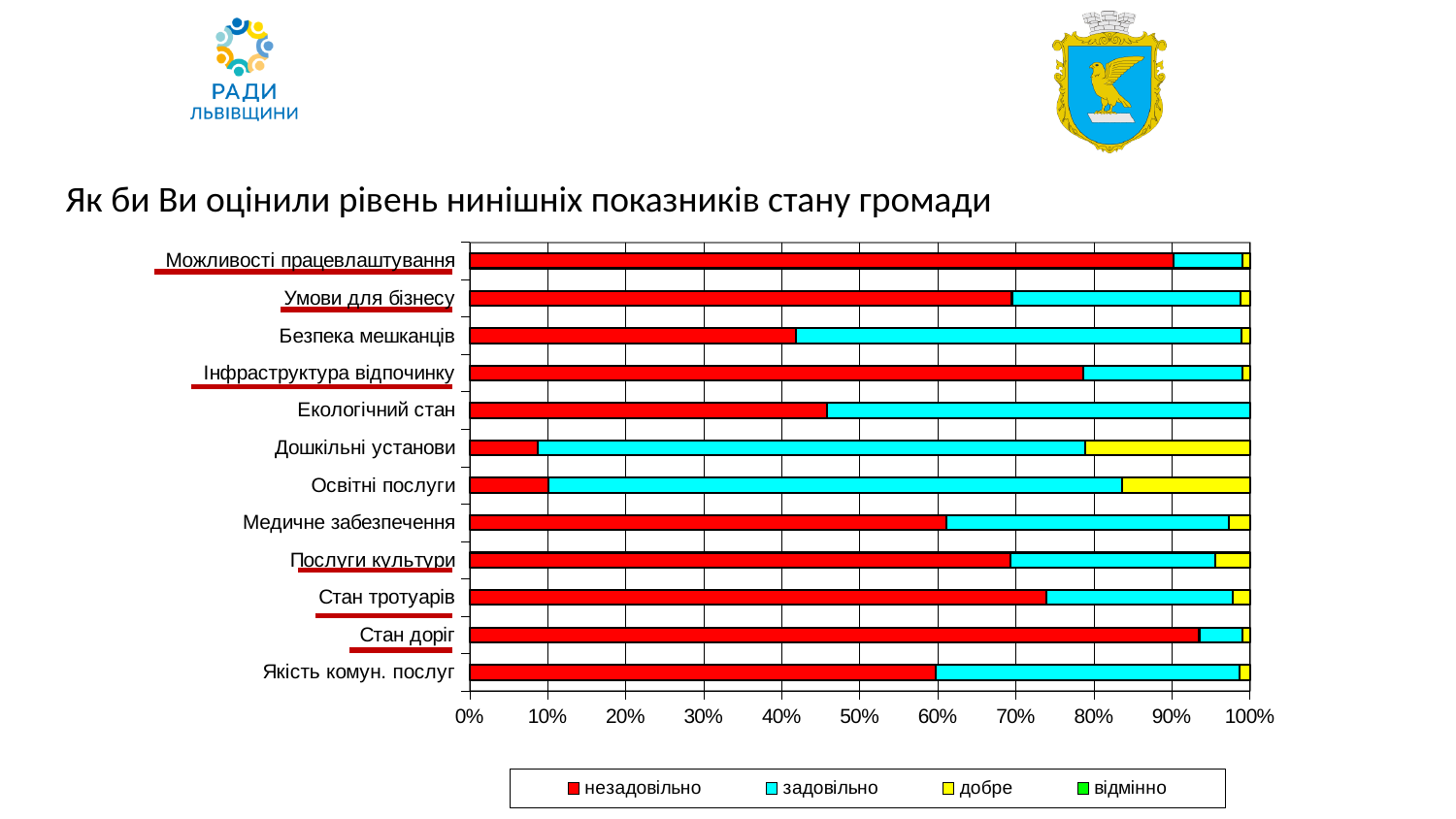
What kind of chart is shown on the slide? Stacked bar chart What is the title of the chart? Як би Ви оцінили рівень нинішніх показників стану громади Which colour represents the series "незадовільно" in the legend? Red Is the "незадовільно" value for Екологічний стан greater or less than 50%? less How many series does the legend list? 4 How many categories are plotted on the chart? 12 Is the "незадовільно" value for Стан доріг greater or less than 90%? greater Is the "незадовільно" value for Дошкільні установи greater or less than 20%? less Which category has the largest "добре" segment? Дошкільні установи Which has the larger "незадовільно" share, Умови для бізнесу or Безпека мешканців? Умови для бізнесу